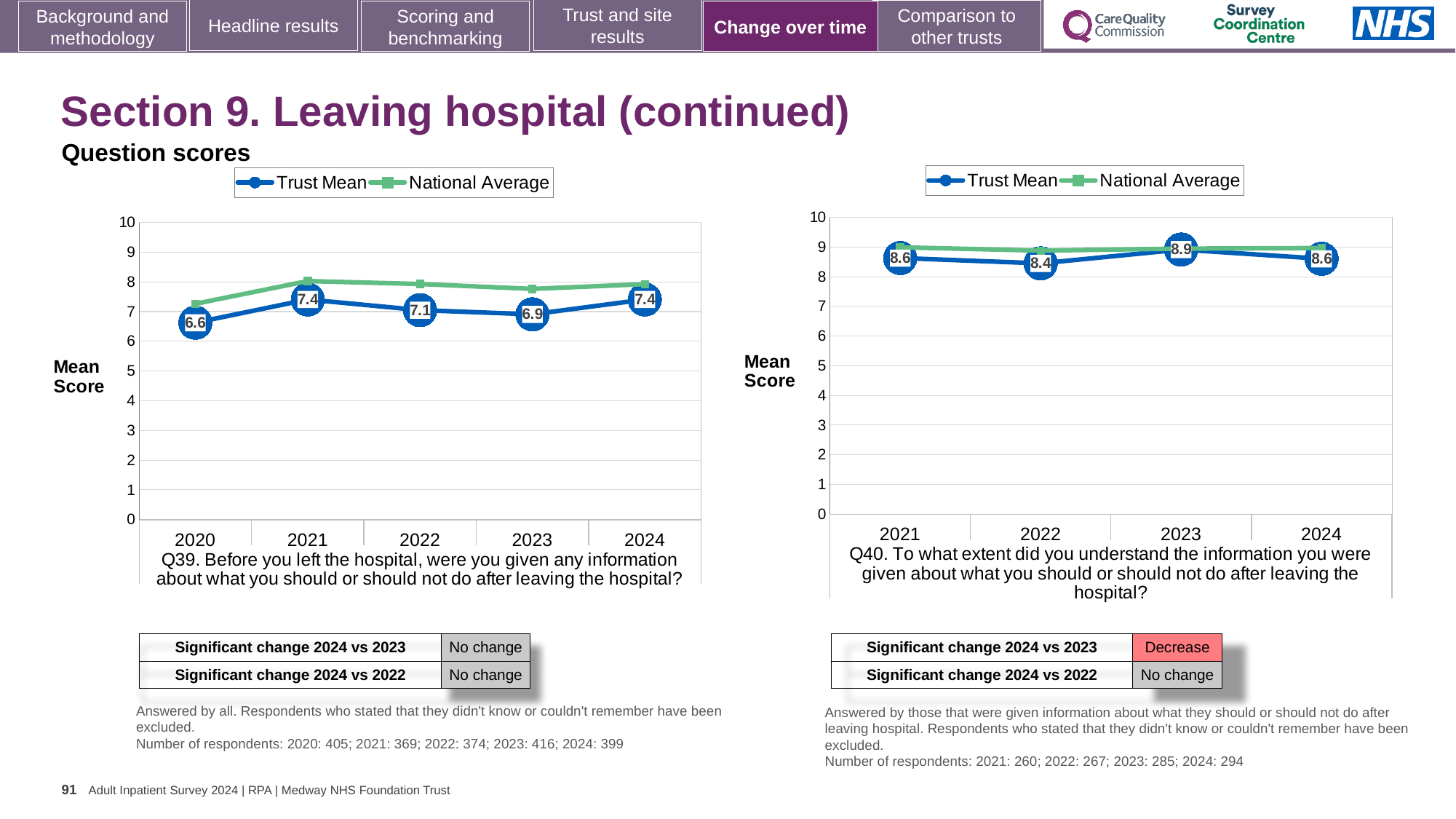
In the Q40 chart on the right, what is the difference between the Trust Mean scores for 2023 and 2022? 0.5 In the Q40 chart on the right, what is the Trust Mean score for 2022? 8.4 How many years are plotted on the x axis of the Q40 chart on the right? 4 In the Q39 chart on the left, is the National Average value for 2021 greater or less than 7? greater How many series does the legend of the Q39 chart on the left list? 2 In the Q39 chart on the left, what is the Trust Mean score for 2023? 6.9 In the Q39 chart on the left, what is the difference between the Trust Mean scores for 2024 and 2020? 0.8 In the Q39 chart on the left, what is the Trust Mean score for 2020? 6.6 In the Q39 chart on the left, is the Trust Mean score for 2022 higher or lower than for 2023? higher In the Q39 chart on the left, which year has the lowest Trust Mean score? 2020 What type of chart is used for the Q39 chart on the left? Line chart In the Q40 chart on the right, which year has the highest Trust Mean score? 2023